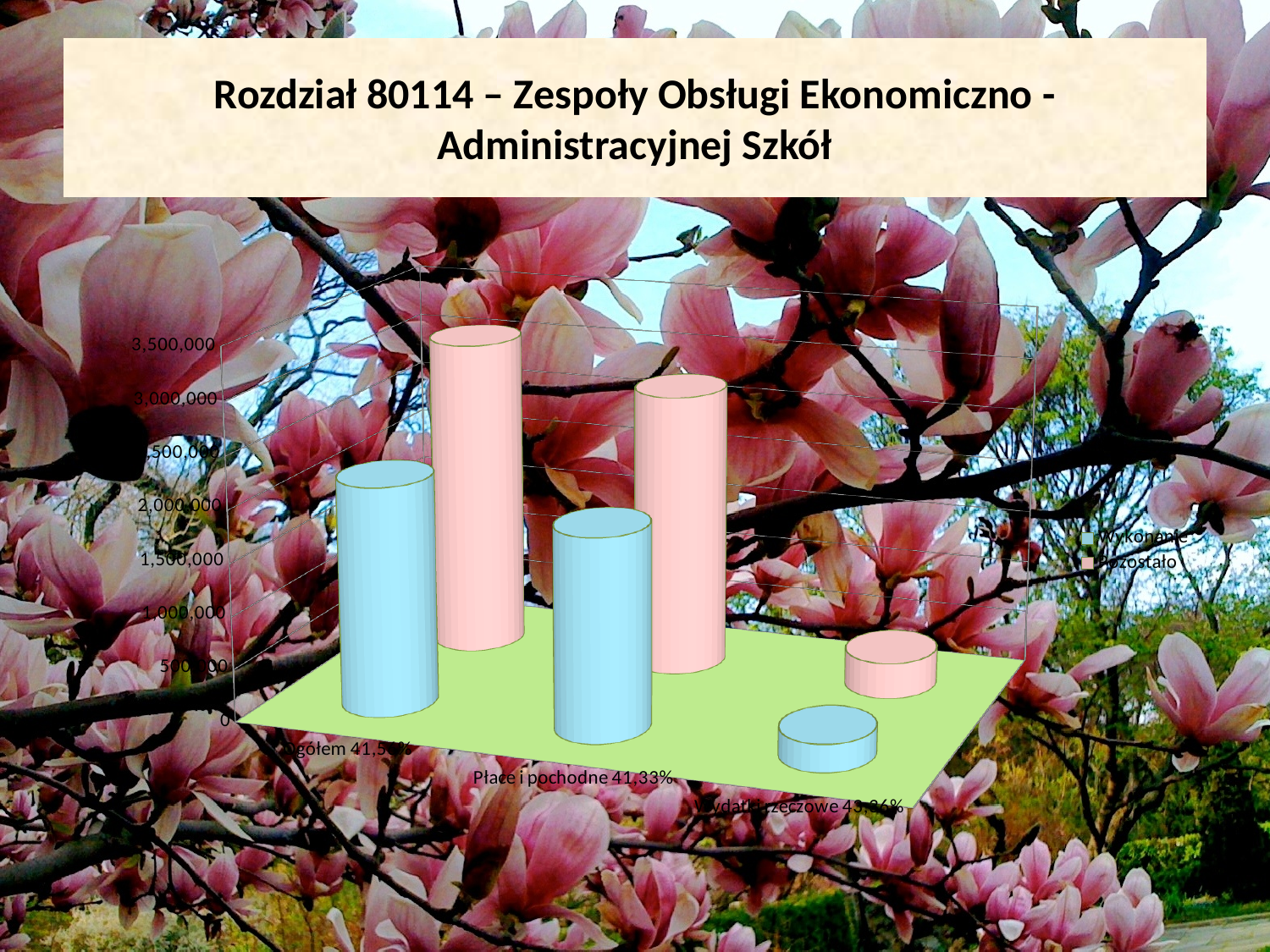
How many categories are plotted along the x axis? 3 How many series does the legend list? 2 For Płace i pochodne, which is larger: Wykonanie or Pozostało? Pozostało What are the two series named in the legend? Wykonanie and Pozostało Is the Wykonanie value for Wydatki rzeczowe greater or less than 500,000? less Is the Pozostało value for Ogółem greater or less than 2,500,000? greater Is the Wykonanie value for Ogółem greater or less than 1,000,000? greater Which colour represents the Wykonanie series? blue For Ogółem, which is larger: Wykonanie or Pozostało? Pozostało What kind of chart is shown on the slide? bar chart Which category has the lowest Wykonanie value? Wydatki rzeczowe Which category has the highest Pozostało value? Ogółem